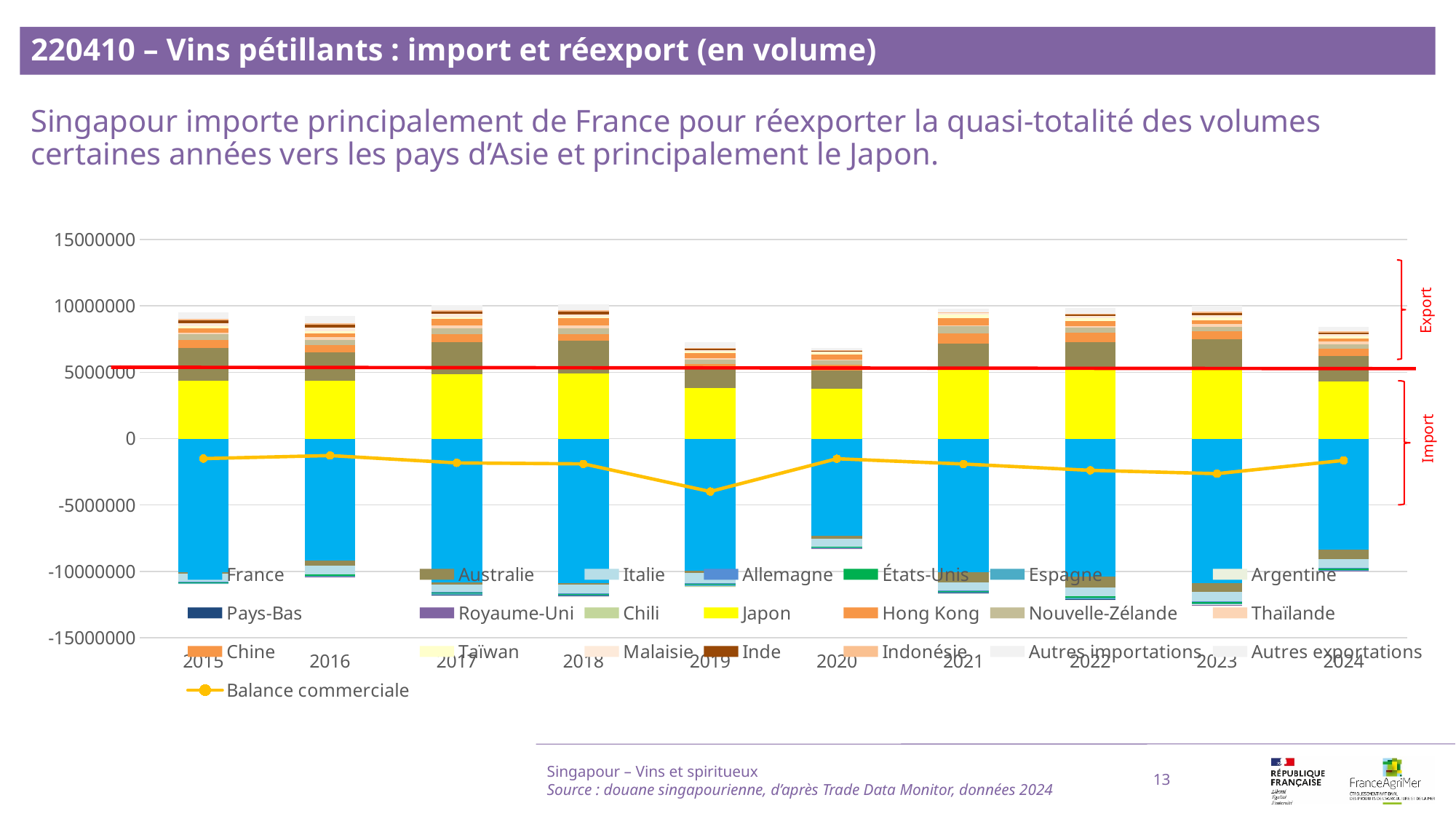
How many years are shown on the x axis of the chart? 10 Is the value for France in 2019 greater or less than -5000000? less How many series does the chart legend list? 22 What kind of chart is shown on the slide? Stacked bar chart with a line Which series is plotted as a line in the chart? Balance commerciale In which year is the Balance commerciale at its lowest? 2019 Is the total export stack in 2020 greater or less than 10000000? less What colour represents Japon in the chart? Yellow Does the Balance commerciale rise or fall from 2016 to 2019? Fall Is the Balance commerciale in 2019 greater or less than -5000000? greater Which is larger, the Balance commerciale in 2016 or in 2019? 2016